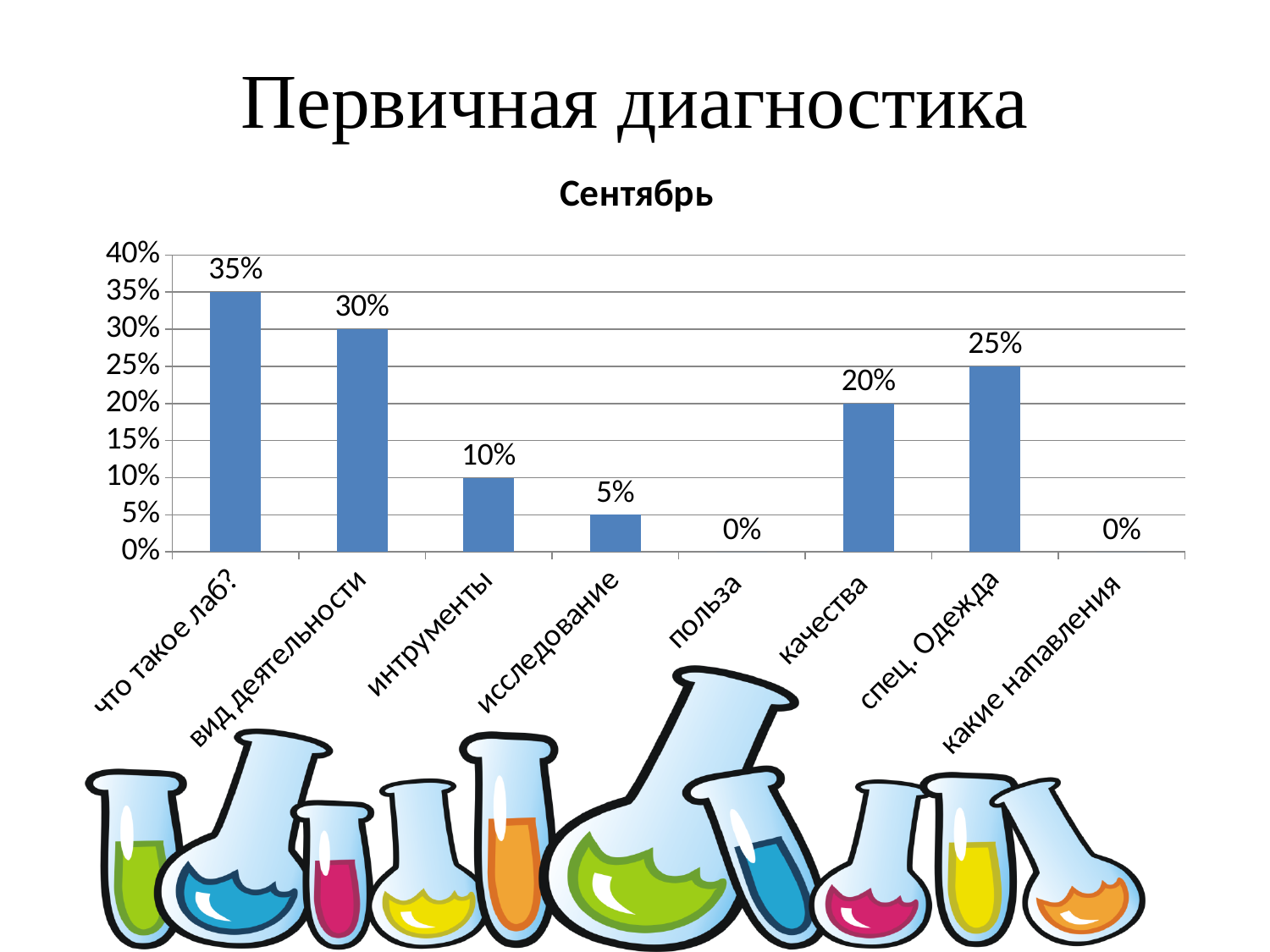
What is the value for "исследование"? 5% What is the highest value shown on the y axis? 40% What is the value for "спец. Одежда"? 25% Which categories have a value of 0%? польза and какие напавления What is the value for "качества"? 20% How many categories are shown on the x axis? 8 What is the difference between "вид деятельности" and "интрументы"? 20% Which is larger, "спец. Одежда" or "качества"? спец. Одежда Which category has the highest value? что такое лаб? What kind of chart is shown? bar chart What is the title of the chart? Сентябрь What is the value for "что такое лаб?"? 35%